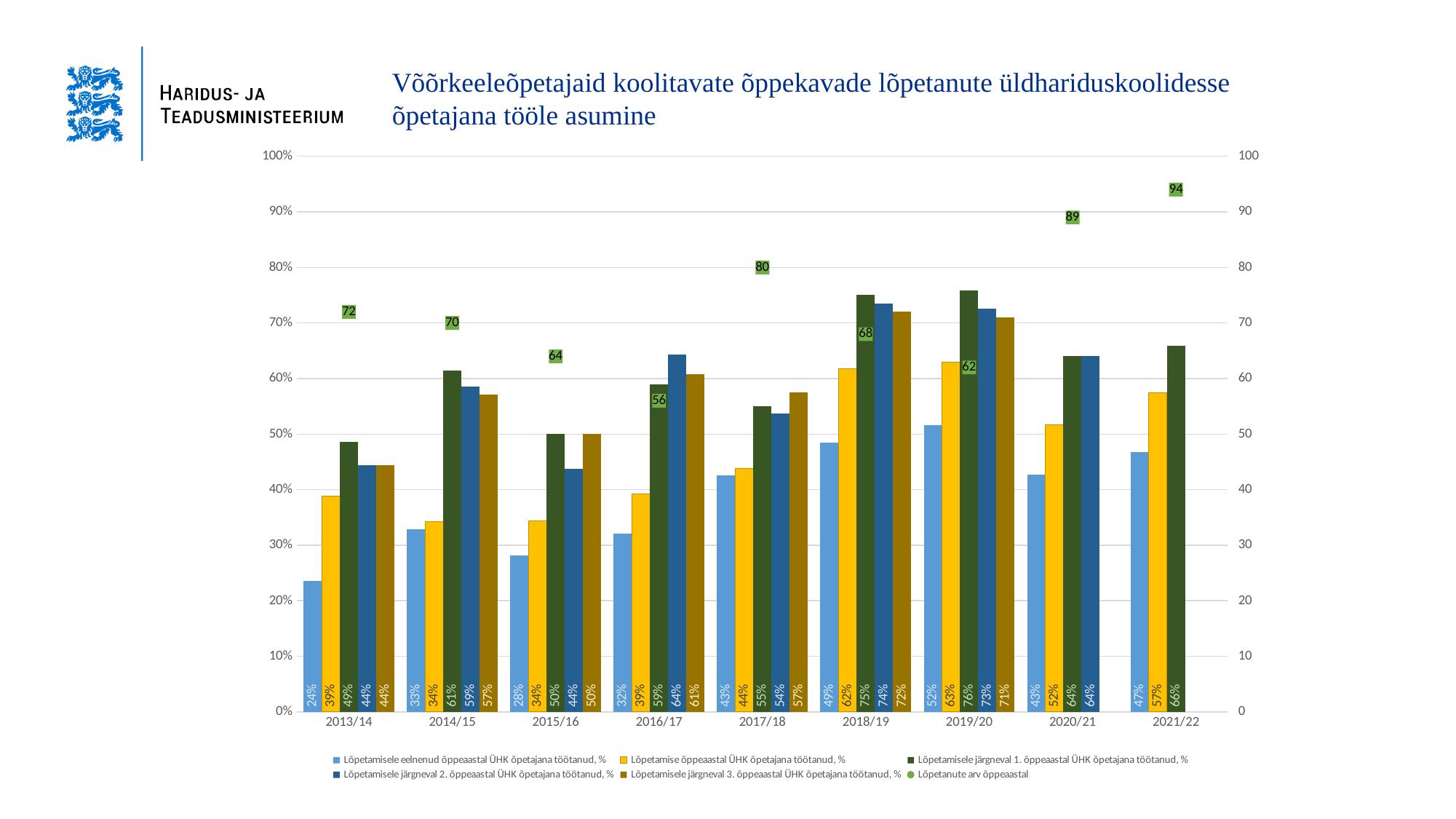
What is the 'Lõpetanute arv õppeaastal' value for 2021/22? 94 In 2016/17, which is larger: the 'Lõpetamisele järgneval 1. õppeaastal' value or the 'Lõpetamisele järgneval 2. õppeaastal' value? Lõpetamisele järgneval 2. õppeaastal (64%) Does 'Lõpetanute arv õppeaastal' rise or fall from 2019/20 to 2021/22? Rises In which academic year is 'Lõpetanute arv õppeaastal' the highest? 2021/22 In which academic year is 'Lõpetanute arv õppeaastal' the lowest? 2016/17 How many academic years are shown on the x axis? 9 What is the difference in percentage points between the 'Lõpetamisele järgneval 1. õppeaastal' value in 2019/20 and in 2013/14? 27 percentage points How many series does the legend list? 6 In which academic year is 'Lõpetamisele eelnenud õppeaastal ÜHK õpetajana töötanud, %' the lowest? 2013/14 In which academic year is 'Lõpetamisele järgneval 1. õppeaastal ÜHK õpetajana töötanud, %' the highest? 2019/20 What is the value for 'Lõpetamise õppeaastal ÜHK õpetajana töötanud, %' in 2018/19? 62% What is the value for 'Lõpetamisele järgneval 2. õppeaastal ÜHK õpetajana töötanud, %' in 2020/21? 64%